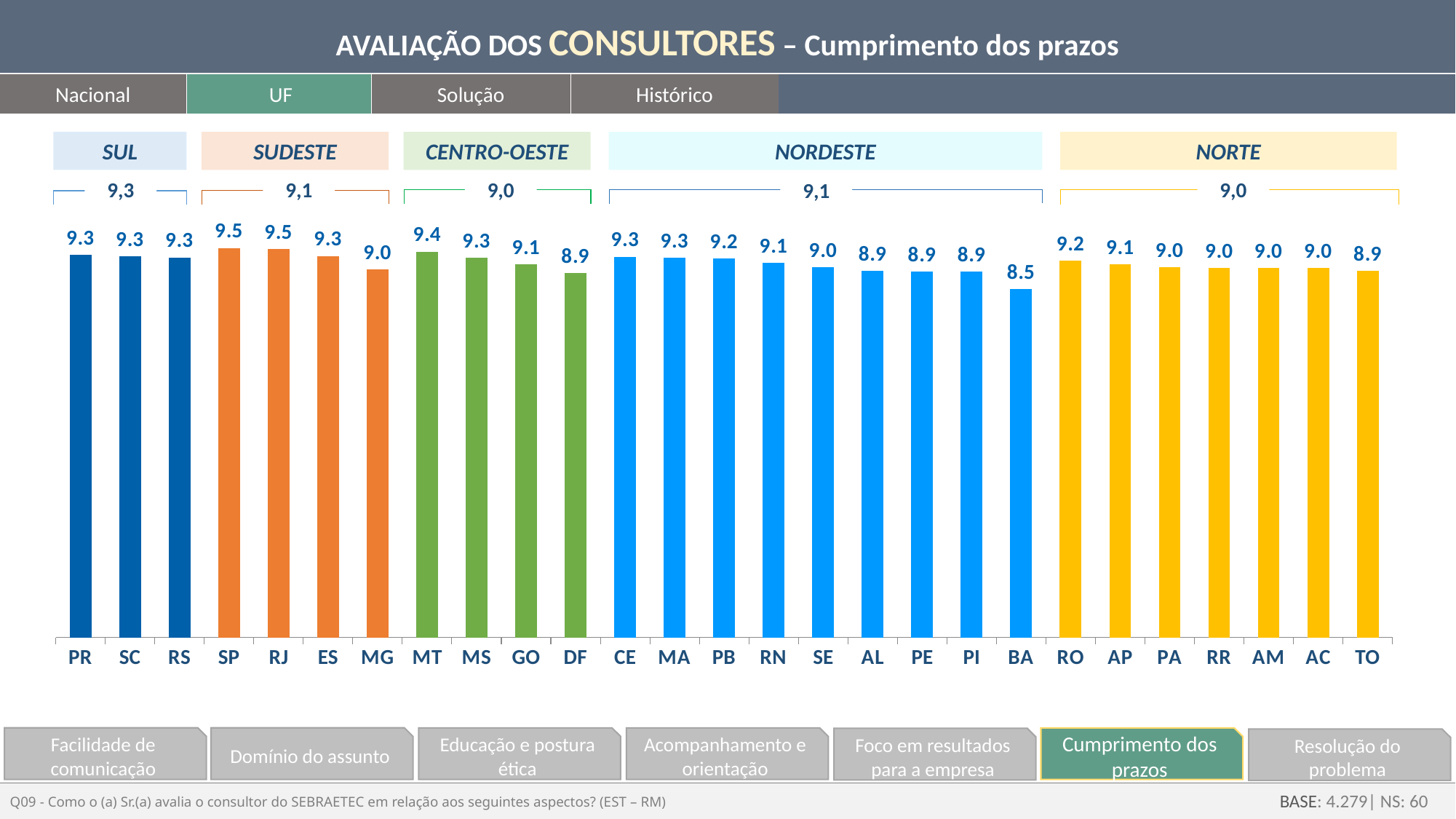
Which is larger, the value for PB or the value for PE? PB How many states (bars) are shown on the chart? 27 What type of chart is shown on the slide? Bar chart What is the value for MT? 9.4 What is the difference between the values for CE and BA? 0.8 Which state in the SUDESTE group has the lowest value? MG What is the value for RO? 9.2 What is the regional average shown above the NORDESTE group? 9,1 What is the value for BA? 8.5 What is the difference between the values for SP and MG? 0.5 Which state has the lowest value on the chart? BA Which state in the CENTRO-OESTE group has the highest value? MT